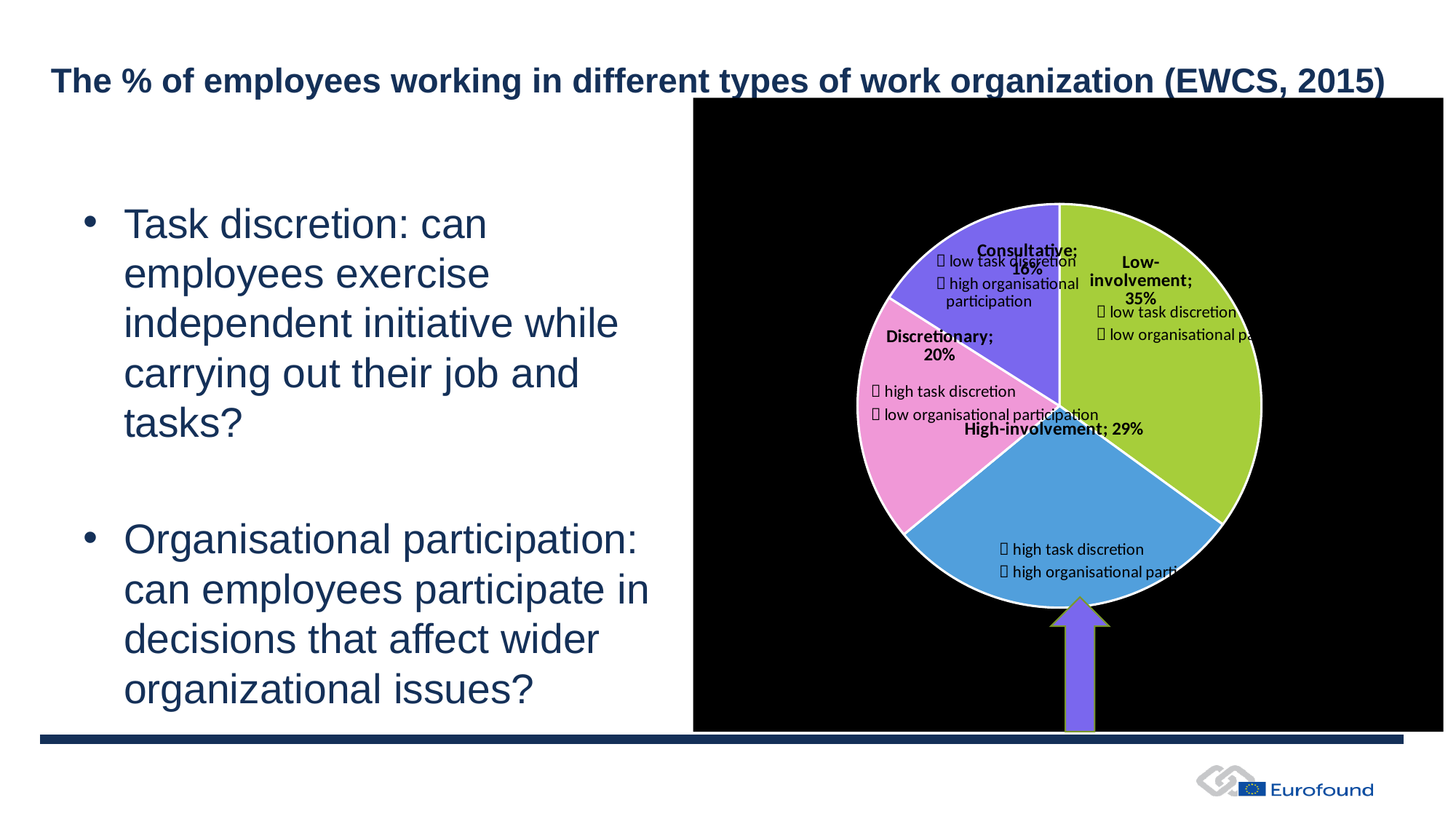
What percentage of employees work in Consultative work organization? 16% What colour is the Low-involvement slice? green Which type of work organization has the smallest share of employees? Consultative Which has a larger share, Discretionary or High-involvement? High-involvement What percentage of employees work in Discretionary work organization? 20% How many slices does the pie chart have? 4 Which type of work organization has the largest share of employees? Low-involvement What is the difference in percentage points between Low-involvement and High-involvement? 6 What percentage of employees work in High-involvement work organization? 29% What percentage of employees work in Low-involvement work organization? 35% What is the difference in percentage points between Discretionary and Consultative? 4 What kind of chart is shown on the slide? pie chart